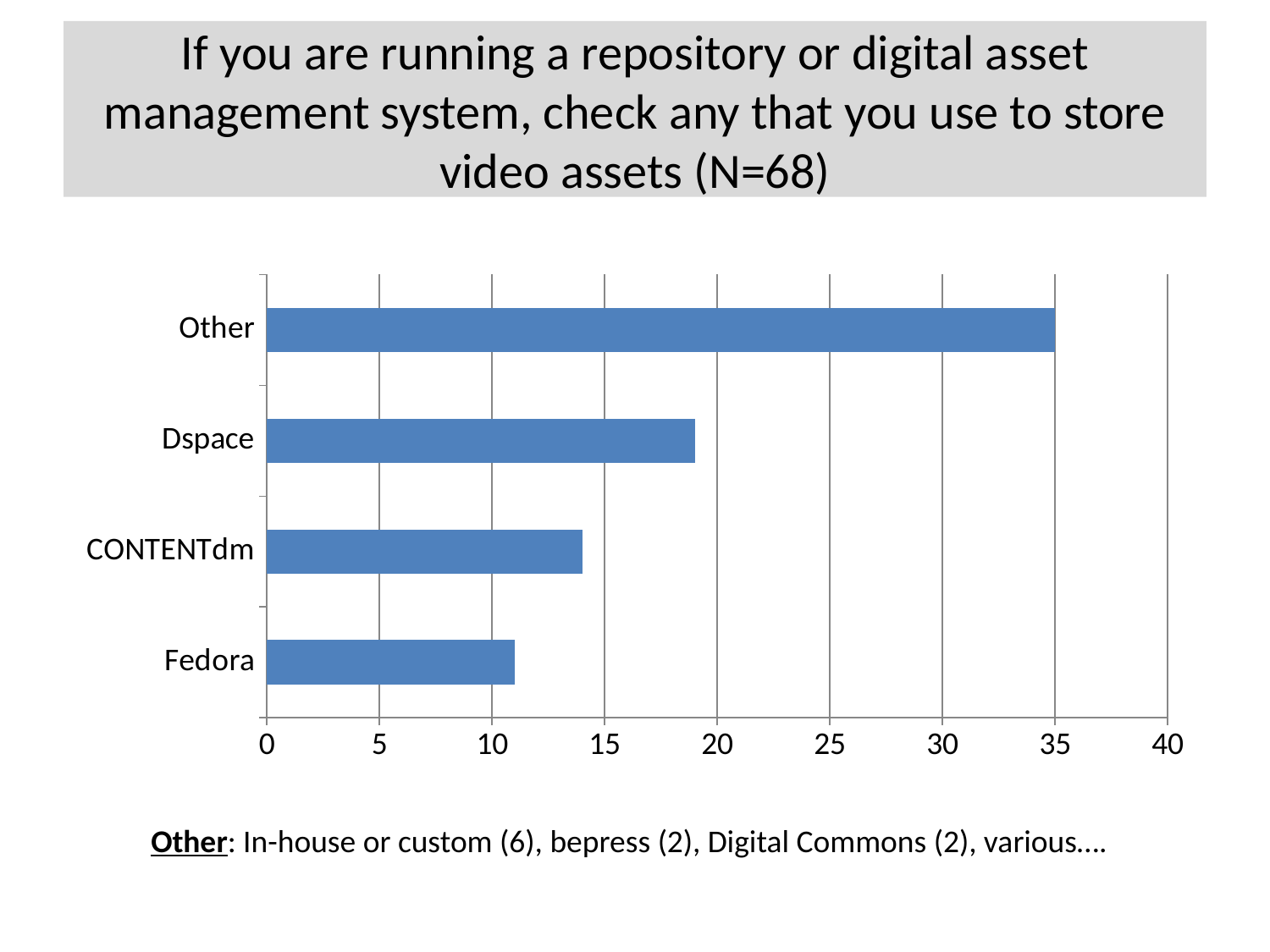
What is the N value given in the chart title? 68 How many categories are plotted in the chart? 4 Which category has the lowest value? Fedora What is the highest value shown on the horizontal axis? 40 Is the value for Dspace greater or less than 15? greater Is the value for CONTENTdm greater or less than 15? less What is the value for Other? 35 What kind of chart is shown on the slide? bar chart Which category has the highest value? Other Is the value for Fedora greater or less than 15? less Which is larger, the value for Dspace or the value for CONTENTdm? Dspace